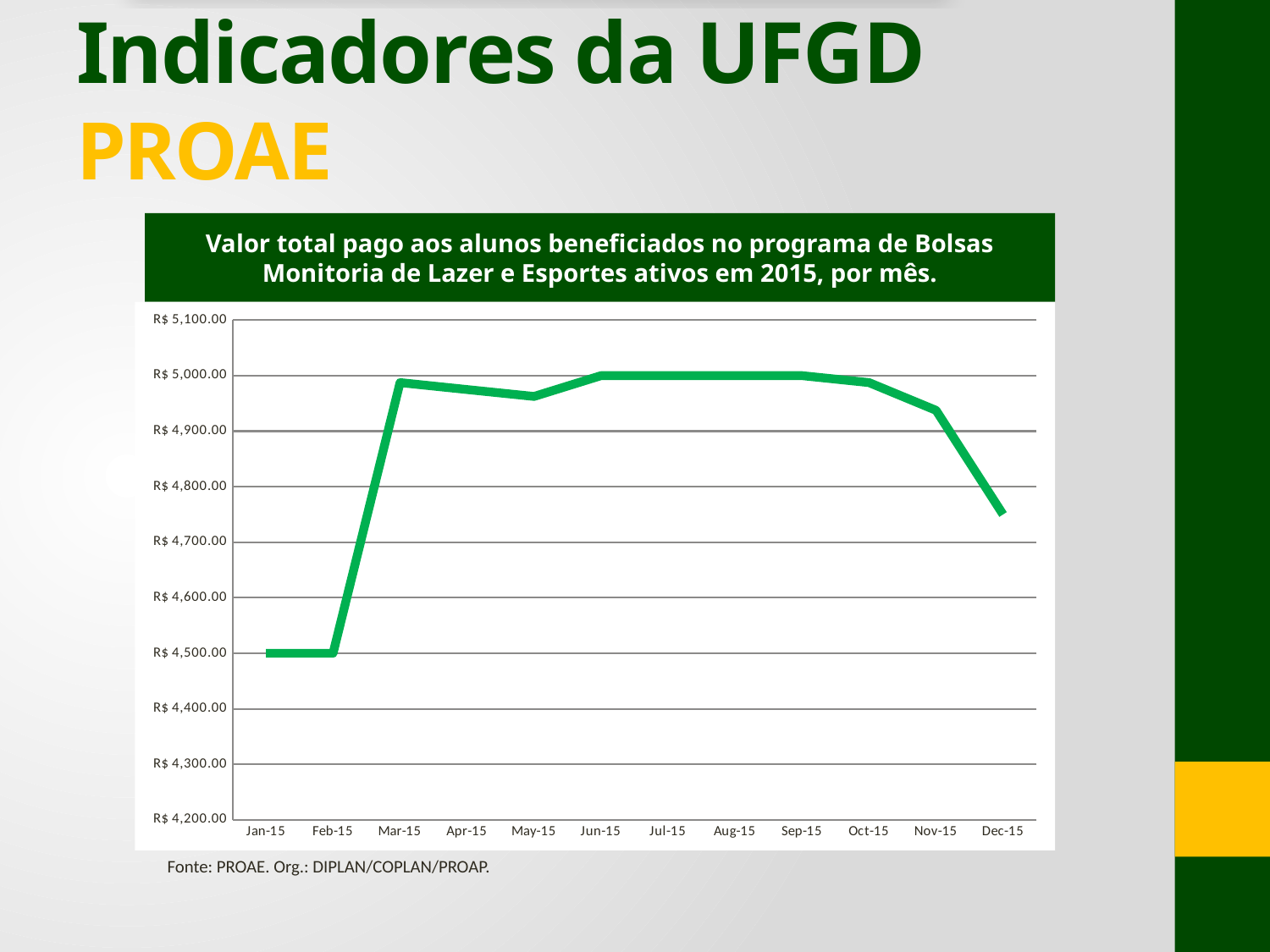
How many months are plotted along the x axis of the chart? 12 Is the value for Feb-15 greater or less than R$ 4,600.00? less Which is larger, the value for Mar-15 or the value for Dec-15? Mar-15 Is the value for Mar-15 greater or less than R$ 4,900.00? greater Do the values rise or fall from Sep-15 to Dec-15? fall What is the value for Jun-15 on the chart? R$ 5,000.00 What kind of chart is shown on the slide? line chart Is the value for Dec-15 greater or less than R$ 4,800.00? less Which is larger, the value for Jan-15 or the value for Nov-15? Nov-15 What is the title of the chart? Valor total pago aos alunos beneficiados no programa de Bolsas Monitoria de Lazer e Esportes ativos em 2015, por mês. What is the value for Jan-15 on the chart? R$ 4,500.00